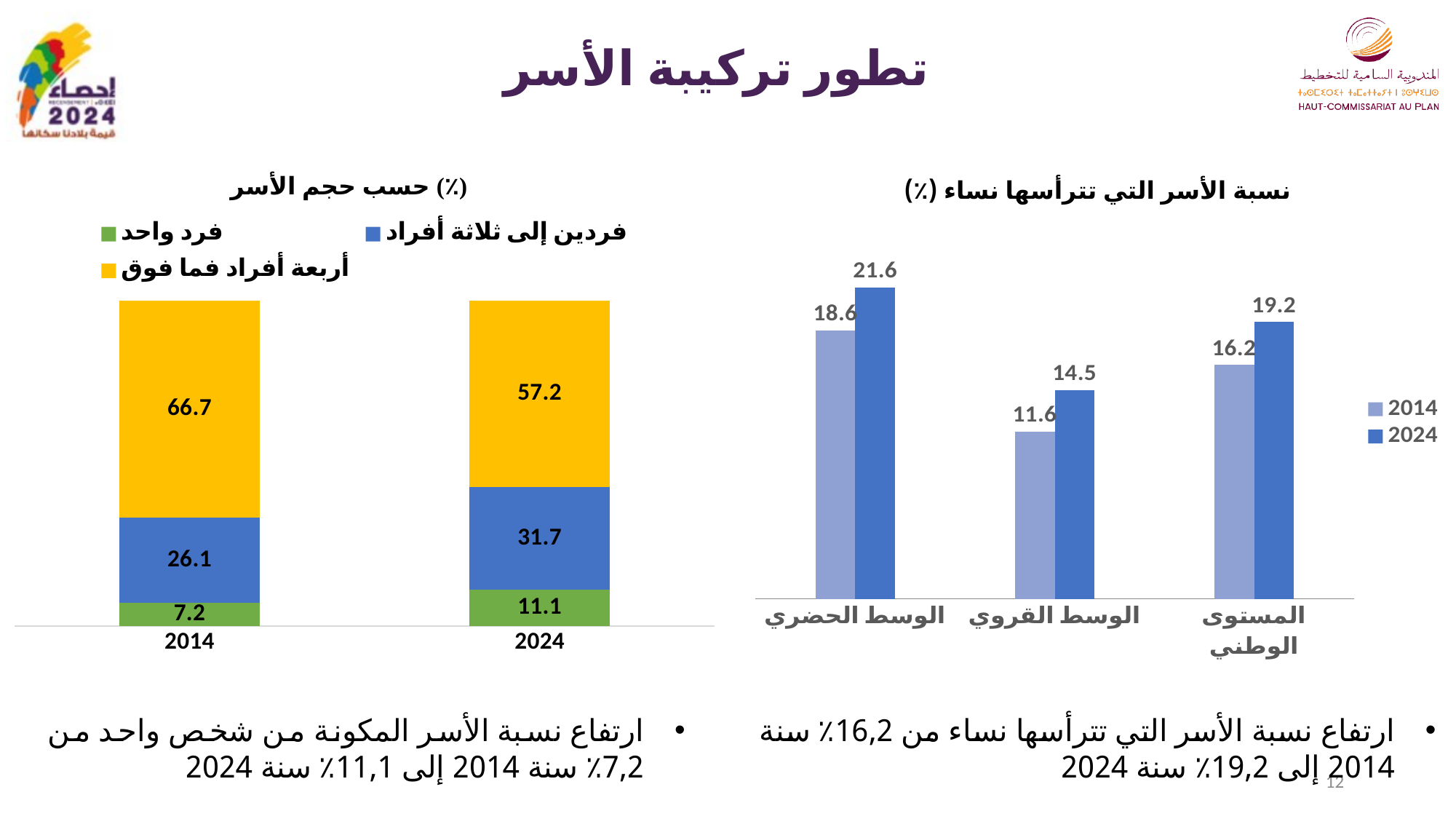
In the chart 'حسب حجم الأسر (%)', what is the difference between the فردين إلى ثلاثة أفراد values for 2024 and 2014? 5.6 In the chart 'نسبة الأسر التي تترأسها نساء (%)', what is the value for الوسط القروي in 2014? 11.6 In the chart 'حسب حجم الأسر (%)', which colour represents فرد واحد? Green What kind of chart is 'حسب حجم الأسر (%)'? Stacked bar chart In the chart 'نسبة الأسر التي تترأسها نساء (%)', which category has the lowest value for 2024? الوسط القروي In the chart 'حسب حجم الأسر (%)', what is the value for فرد واحد in 2024? 11.1 In the chart 'نسبة الأسر التي تترأسها نساء (%)', how many categories are shown on the x axis? 3 In the chart 'نسبة الأسر التي تترأسها نساء (%)', what is the difference between the 2024 and 2014 values for المستوى الوطني? 3.0 In the chart 'نسبة الأسر التي تترأسها نساء (%)', how many series does the legend list? 2 In the chart 'حسب حجم الأسر (%)', what is the value for أربعة أفراد فما فوق in 2014? 66.7 In the chart 'نسبة الأسر التي تترأسها نساء (%)', what is the value for الوسط الحضري in 2024? 21.6 In the chart 'حسب حجم الأسر (%)', which is larger: أربعة أفراد فما فوق in 2014 or in 2024? 2014